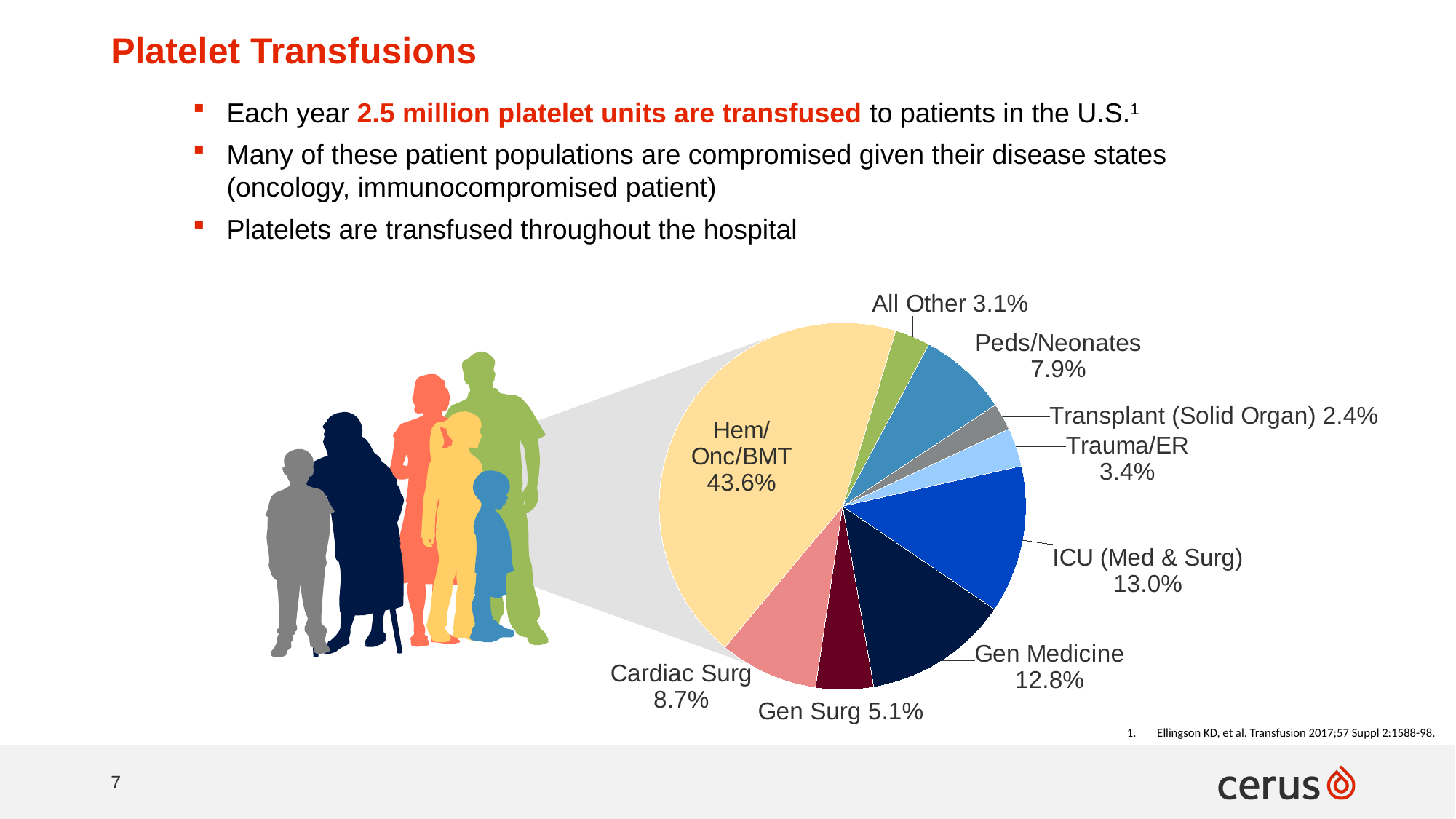
What is the value for Peds/Neonates? 7.9% What is the value for Cardiac Surg? 8.7% What is the value for ICU (Med & Surg)? 13.0% What kind of chart is shown on the slide? Pie chart What is the difference between the Hem/Onc/BMT share and the All Other share? 40.5% How many slices does the pie chart have? 9 Which is larger, Cardiac Surg or Gen Surg? Cardiac Surg What is the difference between the ICU (Med & Surg) and Gen Medicine shares? 0.2% Which category has the largest slice of the pie? Hem/Onc/BMT What is the value for Transplant (Solid Organ)? 2.4% Which category has the smallest slice of the pie? Transplant (Solid Organ) What share of platelet transfusions goes to Hem/Onc/BMT? 43.6%